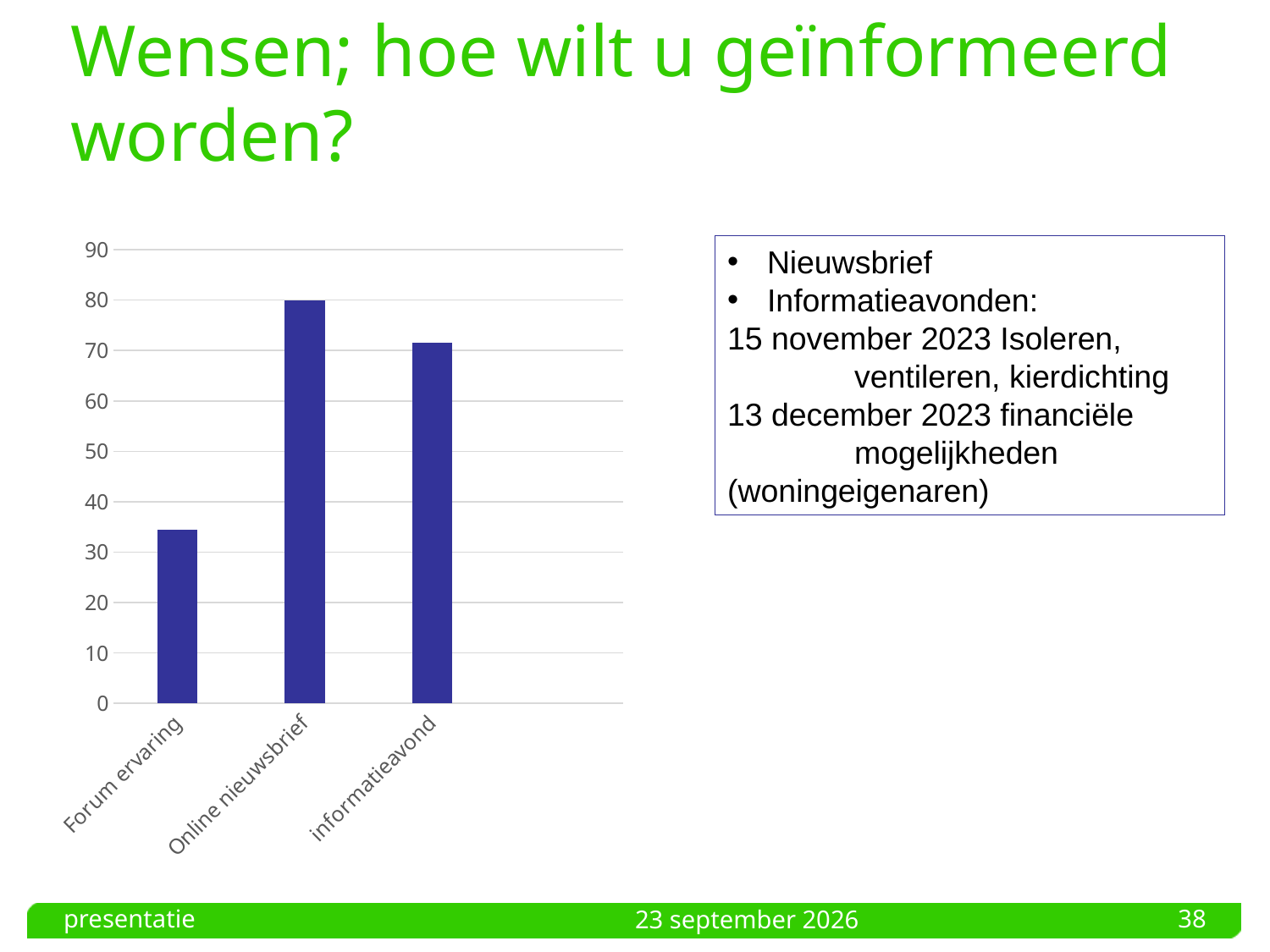
Which category has the lowest bar in the chart? Forum ervaring What is the highest value shown on the vertical axis of the chart? 90 Which is larger, the value for Forum ervaring or the value for informatieavond? informatieavond What colour are the bars in the chart? blue What kind of chart is shown on the slide? bar chart Is the value for informatieavond greater or less than 80? less Which is larger, the value for Online nieuwsbrief or the value for informatieavond? Online nieuwsbrief How many categories are shown on the x axis of the chart? 3 Which category has the highest bar in the chart? Online nieuwsbrief Is the value for Forum ervaring greater or less than 30? greater Is the value for Forum ervaring greater or less than 40? less